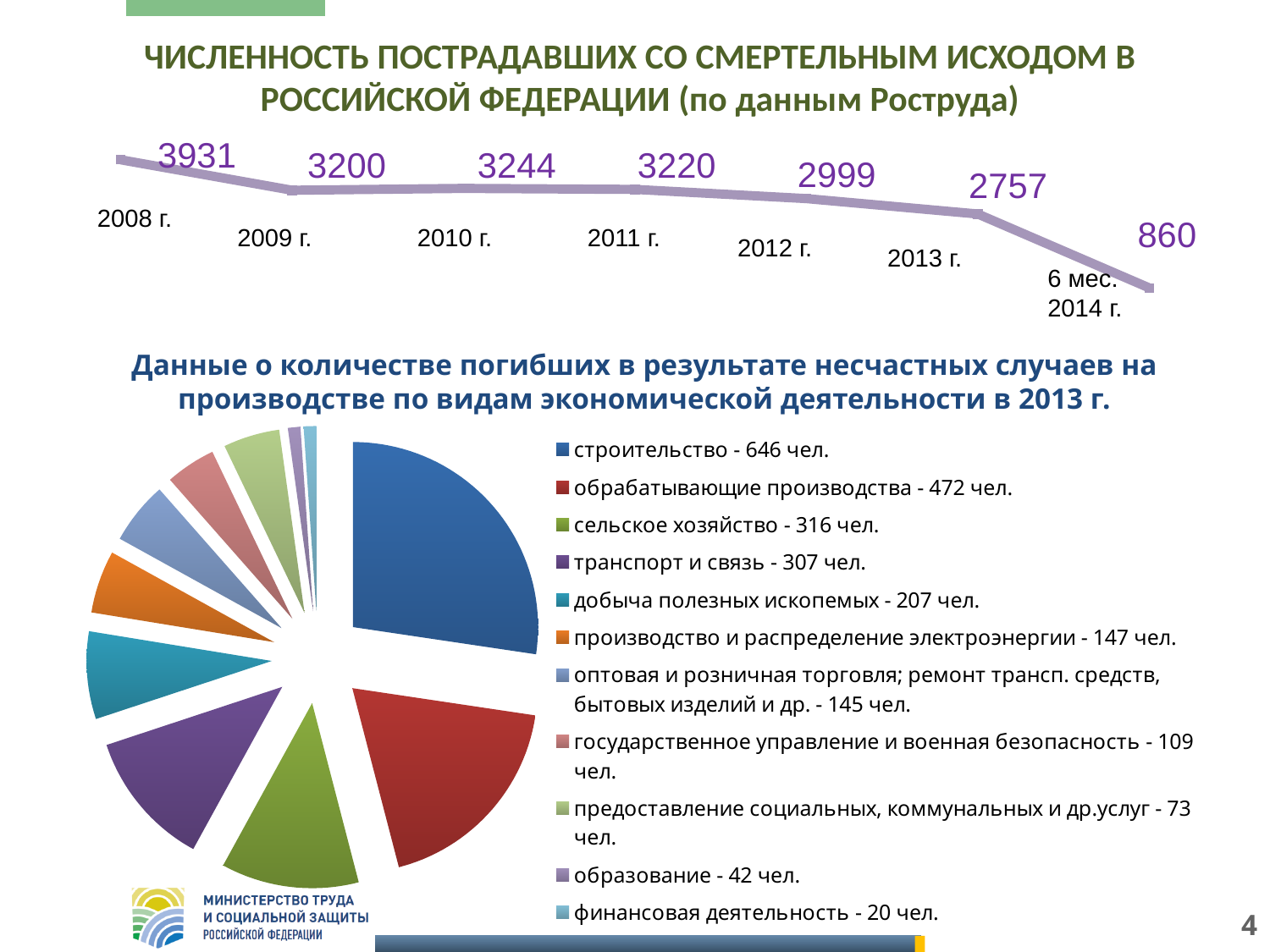
How many data points are plotted in the top line chart? 7 In the top line chart, which year has the highest value? 2008 г. In the top line chart, what is the difference between the values for 2008 г. and 2013 г.? 1174 In the top line chart, do the values generally rise or fall from 2008 г. to 6 мес. 2014 г.? fall In the top line chart, which is larger: the value for 2010 г. or for 2011 г.? 2010 г. In the bottom pie chart, how many people died in строительство? 646 чел. In the bottom pie chart, which category has the smallest value? финансовая деятельность What kind of chart is the top chart titled «ЧИСЛЕННОСТЬ ПОСТРАДАВШИХ СО СМЕРТЕЛЬНЫМ ИСХОДОМ В РОССИЙСКОЙ ФЕДЕРАЦИИ»? line chart How many categories does the legend of the bottom pie chart list? 11 In the top line chart, what is the value for 2008 г.? 3931 In the top line chart, what is the value for 2012 г.? 2999 What kind of chart is the bottom chart about deaths by type of economic activity in 2013? pie chart